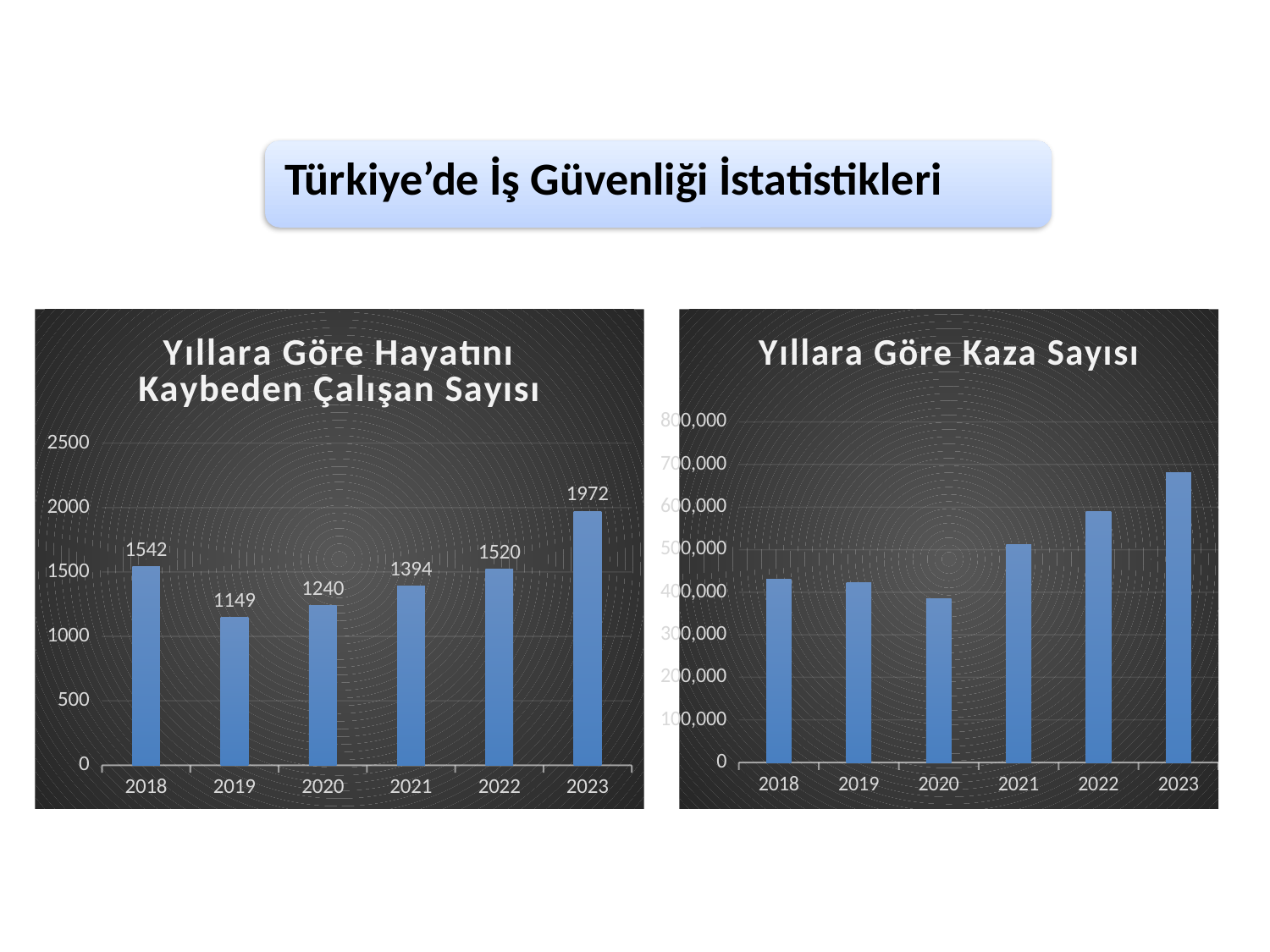
In the chart 'Yıllara Göre Kaza Sayısı', which year has the highest value? 2023 In the chart 'Yıllara Göre Hayatını Kaybeden Çalışan Sayısı', what is the difference between the values for 2023 and 2022? 452 In the chart 'Yıllara Göre Kaza Sayısı', is the value for 2020 greater or less than 400,000? less In the chart 'Yıllara Göre Hayatını Kaybeden Çalışan Sayısı', what is the value for 2018? 1542 In the chart 'Yıllara Göre Kaza Sayısı', is the value for 2023 greater or less than 600,000? greater In the chart 'Yıllara Göre Hayatını Kaybeden Çalışan Sayısı', which is larger, the value for 2018 or the value for 2022? 2018 In the chart 'Yıllara Göre Hayatını Kaybeden Çalışan Sayısı', which year has the lowest value? 2019 What kind of chart is 'Yıllara Göre Kaza Sayısı'? Bar chart In the chart 'Yıllara Göre Kaza Sayısı', which year has the lowest value? 2020 In the chart 'Yıllara Göre Hayatını Kaybeden Çalışan Sayısı', which year has the highest value? 2023 In the chart 'Yıllara Göre Hayatını Kaybeden Çalışan Sayısı', how many years are shown on the x axis? 6 In the chart 'Yıllara Göre Hayatını Kaybeden Çalışan Sayısı', what is the value for 2021? 1394